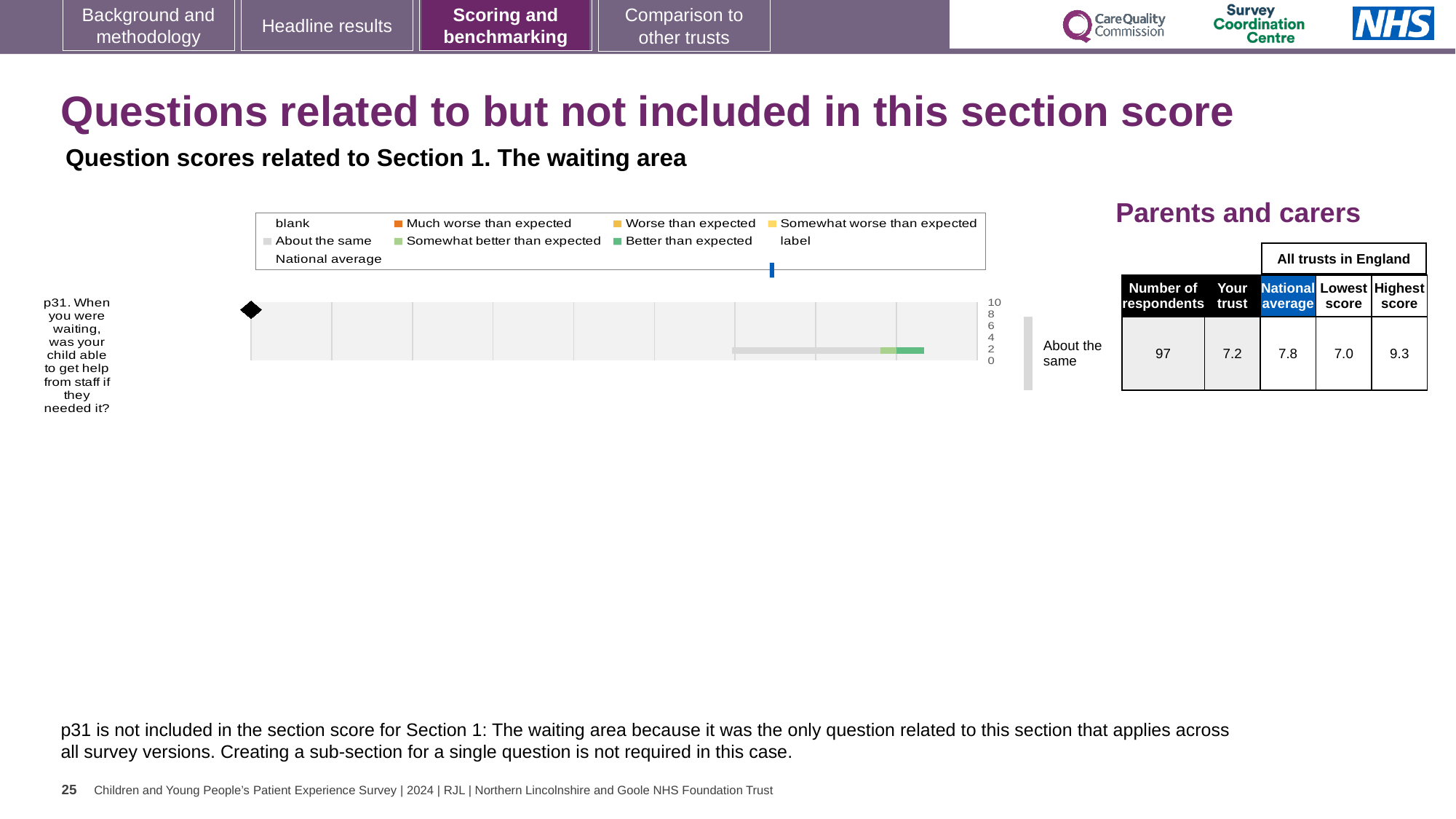
Which question is plotted in the chart? p31. When you were waiting, was your child able to get help from staff if they needed it? In the table next to the chart, what is the lowest score among all trusts in England for p31? 7.0 What category label is shown to the right of the bar for p31? About the same In the table next to the chart, how many respondents answered p31? 97 What is the highest value shown on the chart's axis? 10 How many questions are plotted in the chart? 1 In the table next to the chart, what is the national average score for p31? 7.8 In the table next to the chart, what is the highest score among all trusts in England for p31? 9.3 What kind of chart is used to show the score for question p31? bar chart In the table next to the chart, what is the 'Your trust' score for p31? 7.2 Which is larger for p31, the 'Your trust' score or the national average? National average What is the difference between the highest score and the lowest score for p31 in the table? 2.3